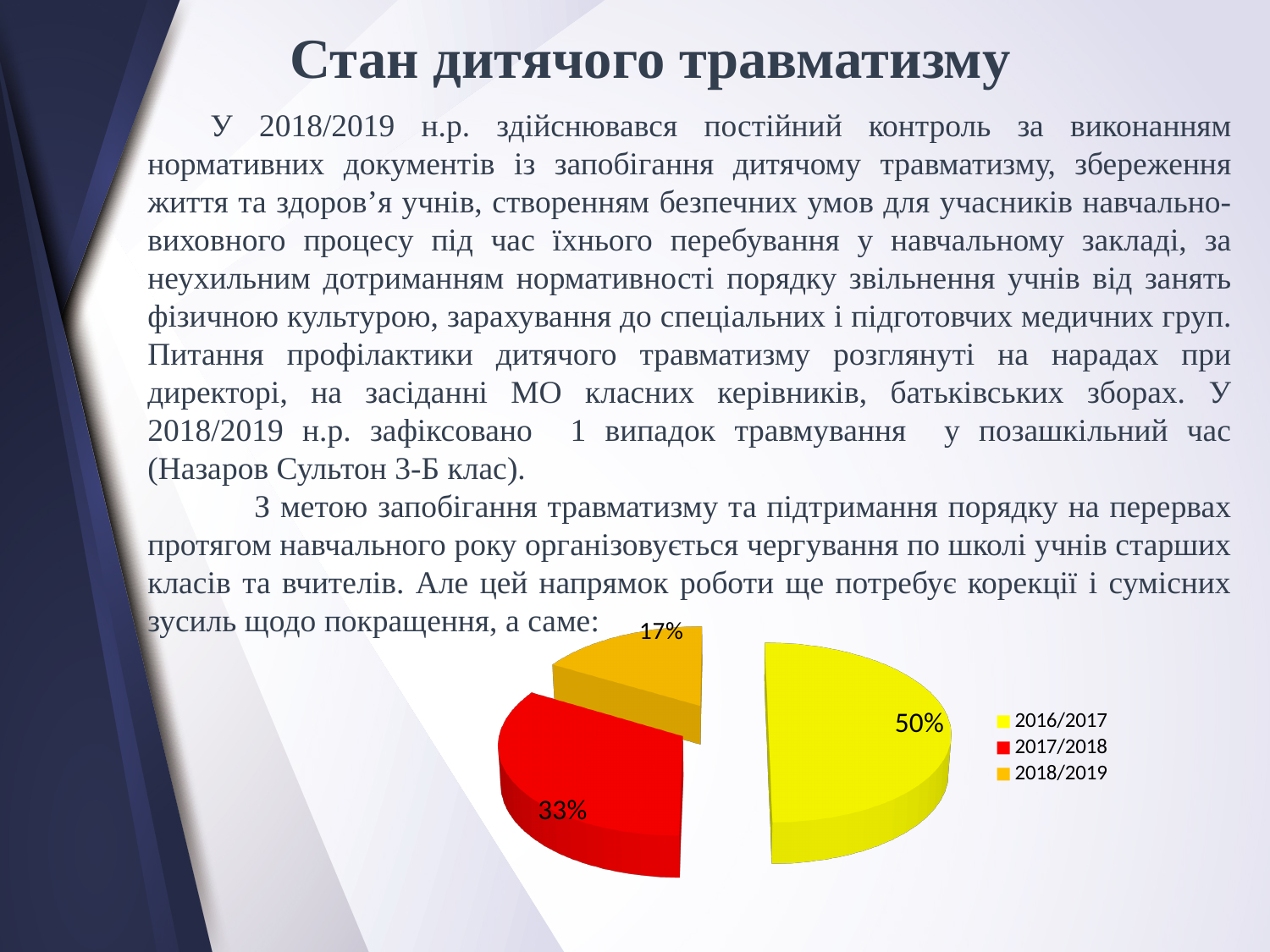
What share of the pie does the 2018/2019 slice represent? 17% What share of the pie does the 2017/2018 slice represent? 33% How many slices does the pie chart have? 3 Which slice is larger, 2017/2018 or 2018/2019? 2017/2018 What colour is the 2017/2018 slice in the pie chart? red What kind of chart is shown on the slide? pie chart How many entries does the legend list? 3 Which category has the largest slice of the pie? 2016/2017 What share of the pie does the 2016/2017 slice represent? 50% What is the difference in percentage points between the 2017/2018 slice and the 2018/2019 slice? 16 Which category has the smallest slice of the pie? 2018/2019 What is the difference in percentage points between the 2016/2017 slice and the 2017/2018 slice? 17